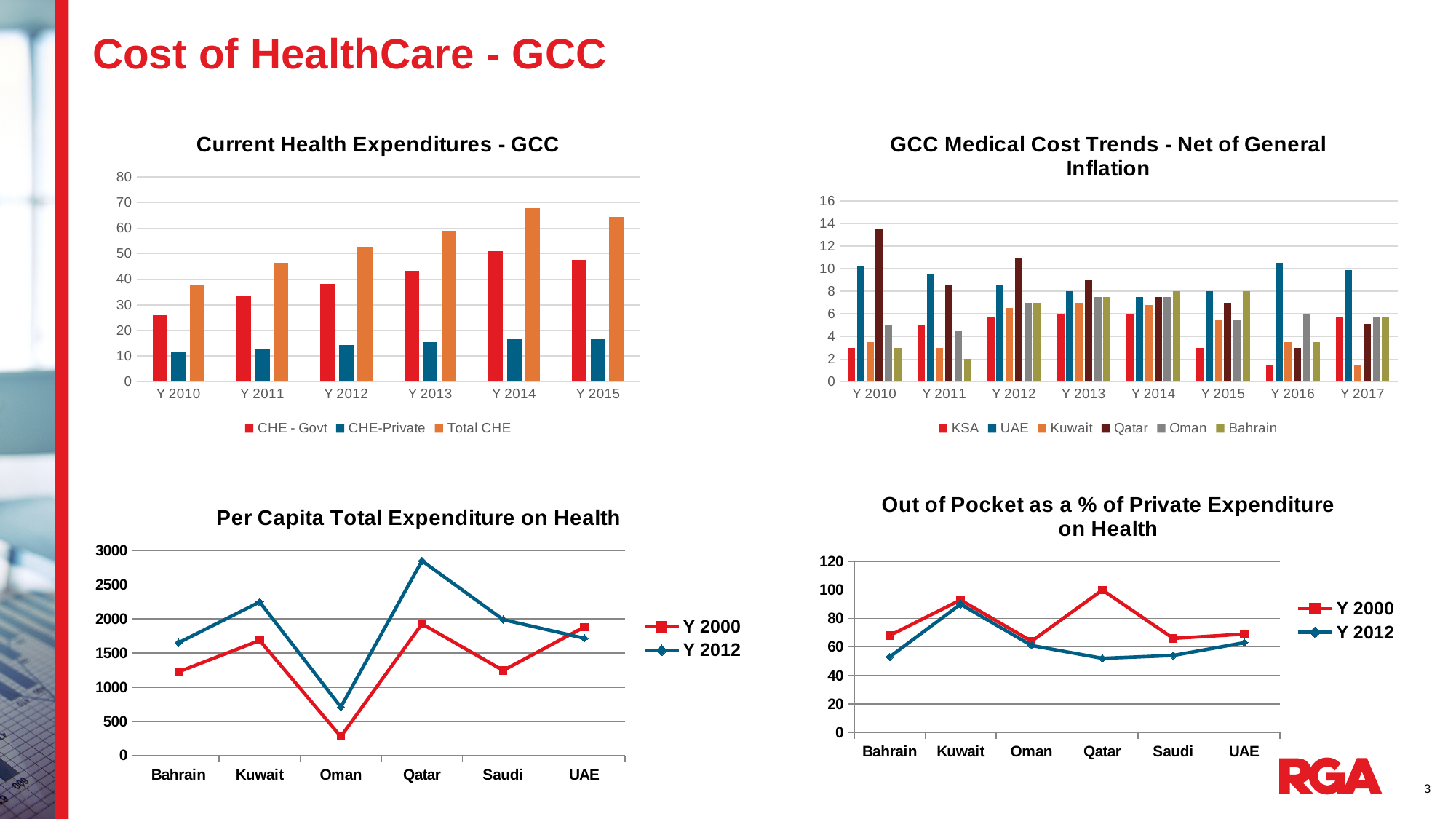
In the 'Current Health Expenditures - GCC' chart, is the Total CHE value for Y 2010 greater or less than 40? less In the 'Per Capita Total Expenditure on Health' chart, which country has the lowest Y 2000 value? Oman In the 'GCC Medical Cost Trends - Net of General Inflation' chart, is the Qatar value for Y 2010 greater or less than 12? greater In the 'Out of Pocket as a % of Private Expenditure on Health' chart, which country has the highest Y 2000 value? Qatar How many years are shown on the x axis of the 'GCC Medical Cost Trends - Net of General Inflation' chart? 8 In the 'Current Health Expenditures - GCC' chart, which year has the highest Total CHE bar? Y 2014 How many countries does the legend of the 'GCC Medical Cost Trends - Net of General Inflation' chart list? 6 In the 'Out of Pocket as a % of Private Expenditure on Health' chart, is the Y 2012 value for Bahrain greater or less than 60? less What type of chart is the 'Current Health Expenditures - GCC' chart? Bar chart How many series does the legend of the 'Current Health Expenditures - GCC' chart list? 3 In the 'Per Capita Total Expenditure on Health' chart, which country has the highest Y 2012 value? Qatar